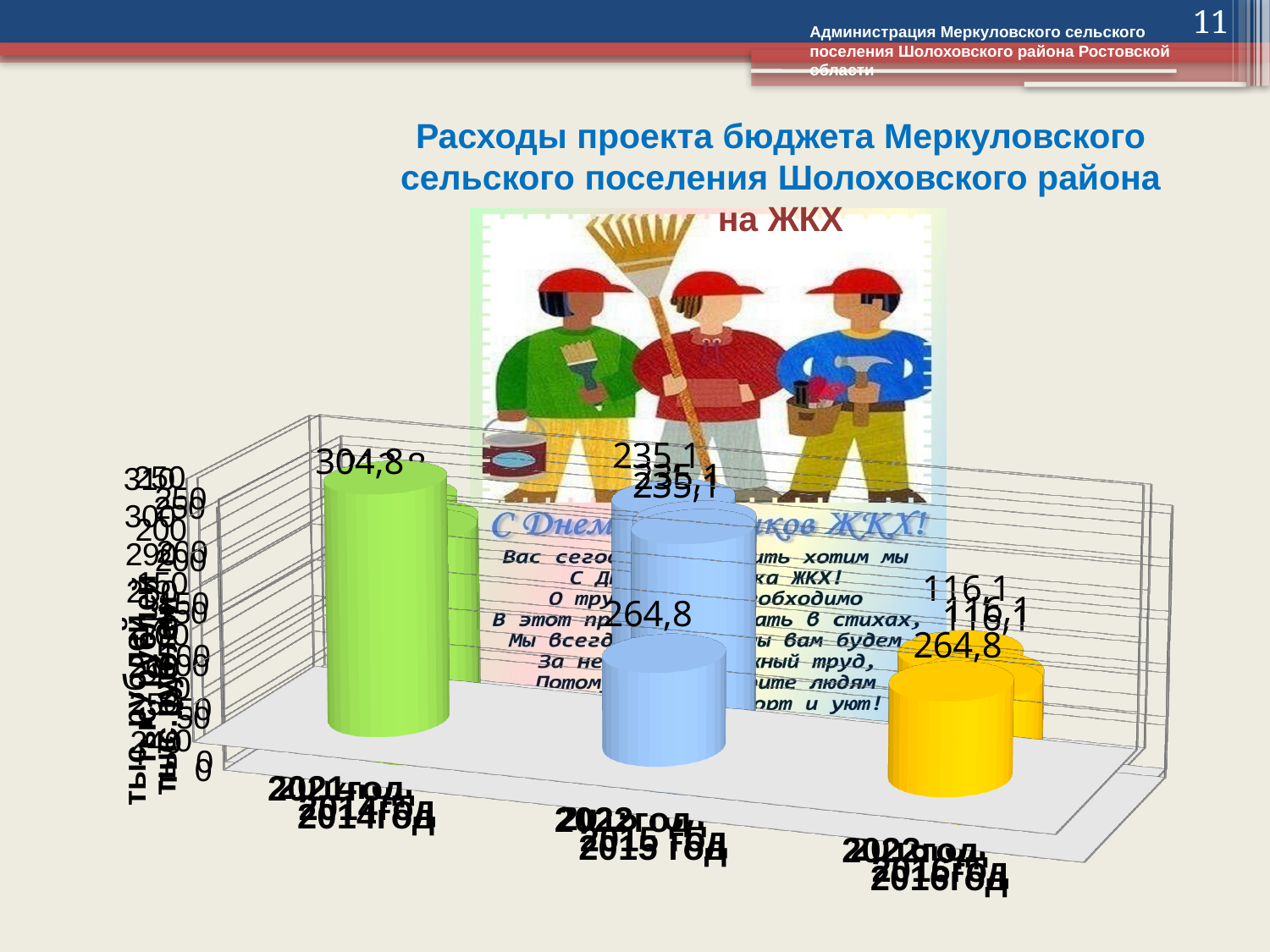
What is the title of the chart on the slide? Расходы проекта бюджета Меркуловского сельского поселения Шолоховского района на ЖКХ How many bars (cylinders) are plotted in the foreground of the chart? 3 What kind of chart is shown on the slide? bar chart Is the value of the green bar greater or less than 300? greater What value is labelled on the green bar? 304,8 Which is larger, the value of the green bar or the value of the blue bar? green bar Which bar is the tallest: the green, the blue or the yellow one? green